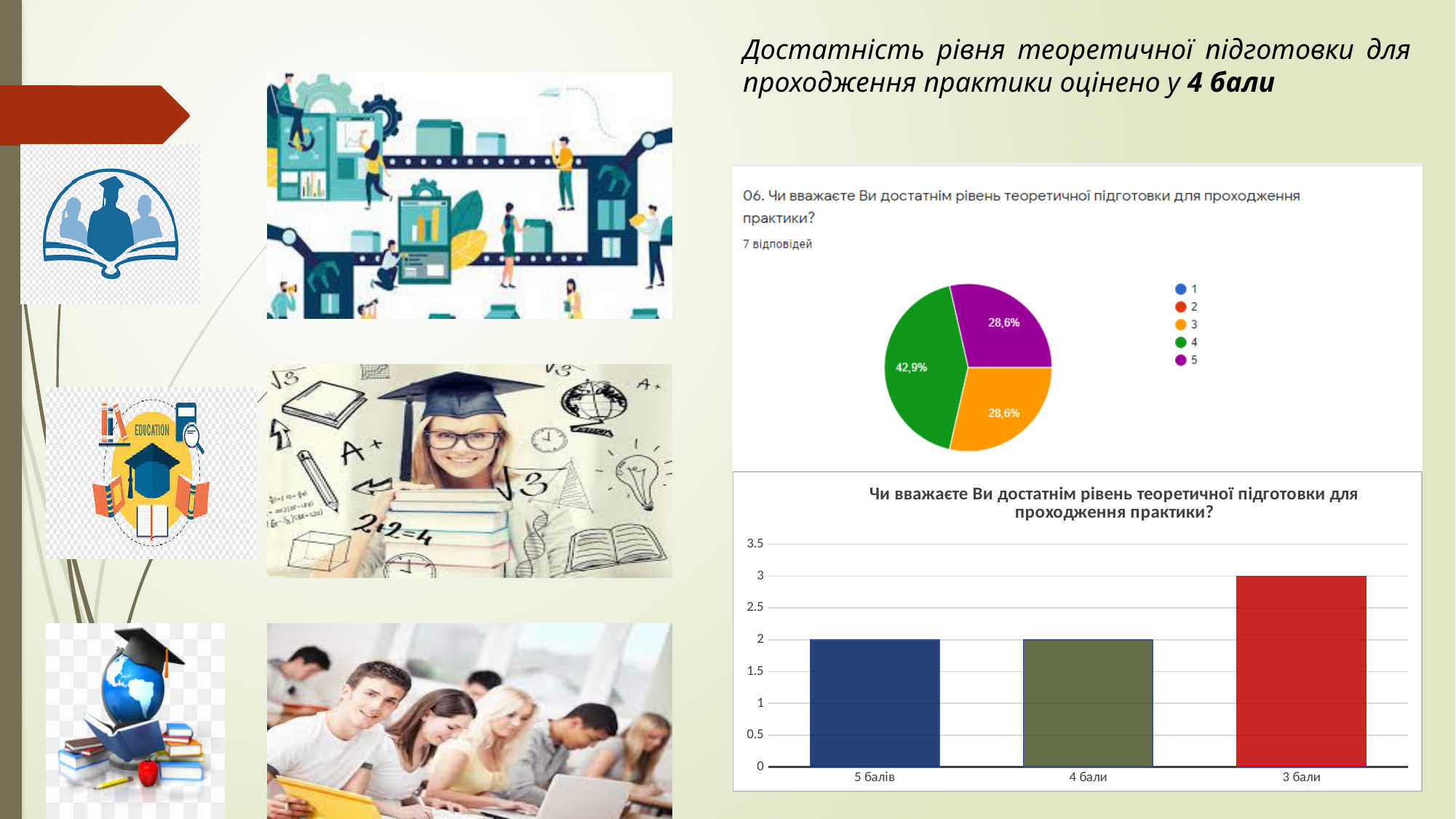
In the pie chart, what colour is the slice for rating 5? Purple What kind of chart is the one at the bottom right of the slide? Bar chart In the pie chart, how many entries does the legend list? 5 In the pie chart, how many responses are reported? 7 In the bar chart at the bottom right, what is the value for '3 бали'? 3 In the pie chart, what share of responses is for rating 4? 42,9% In the bar chart at the bottom right, what is the difference between the values for '3 бали' and '4 бали'? 1 In the bar chart at the bottom right, how many categories are shown on the x axis? 3 In the pie chart, what share of responses is for rating 3? 28,6% In the bar chart at the bottom right, what is the value for '5 балів'? 2 In the pie chart, which rating has the largest slice? 4 In the bar chart at the bottom right, which category has the highest value? 3 бали